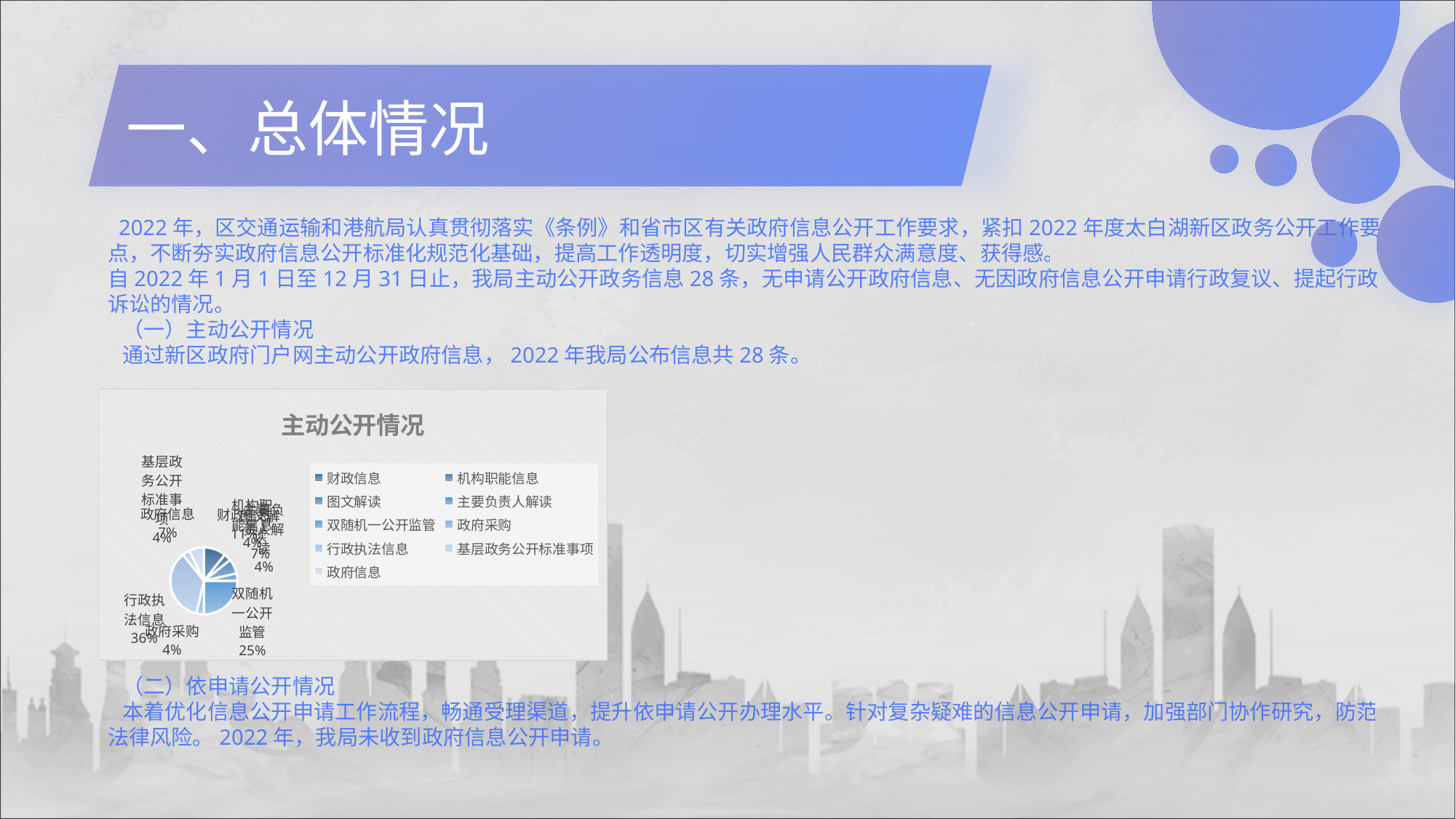
Which is larger, the share for 行政执法信息 or the share for 双随机一公开监管? 行政执法信息 How many categories does the chart's legend list? 9 What kind of chart is shown on the slide? pie chart Which category has the largest share of the pie? 行政执法信息 What share of the pie does 行政执法信息 account for? 36% By how many percentage points does the share for 行政执法信息 exceed the share for 双随机一公开监管? 11 What share of the pie does 财政信息 account for? 11% What is the title of the chart? 主动公开情况 What share of the pie does 双随机一公开监管 account for? 25% How many slices does the pie chart have? 9 Which is larger, the share for 财政信息 or the share for 政府采购? 财政信息